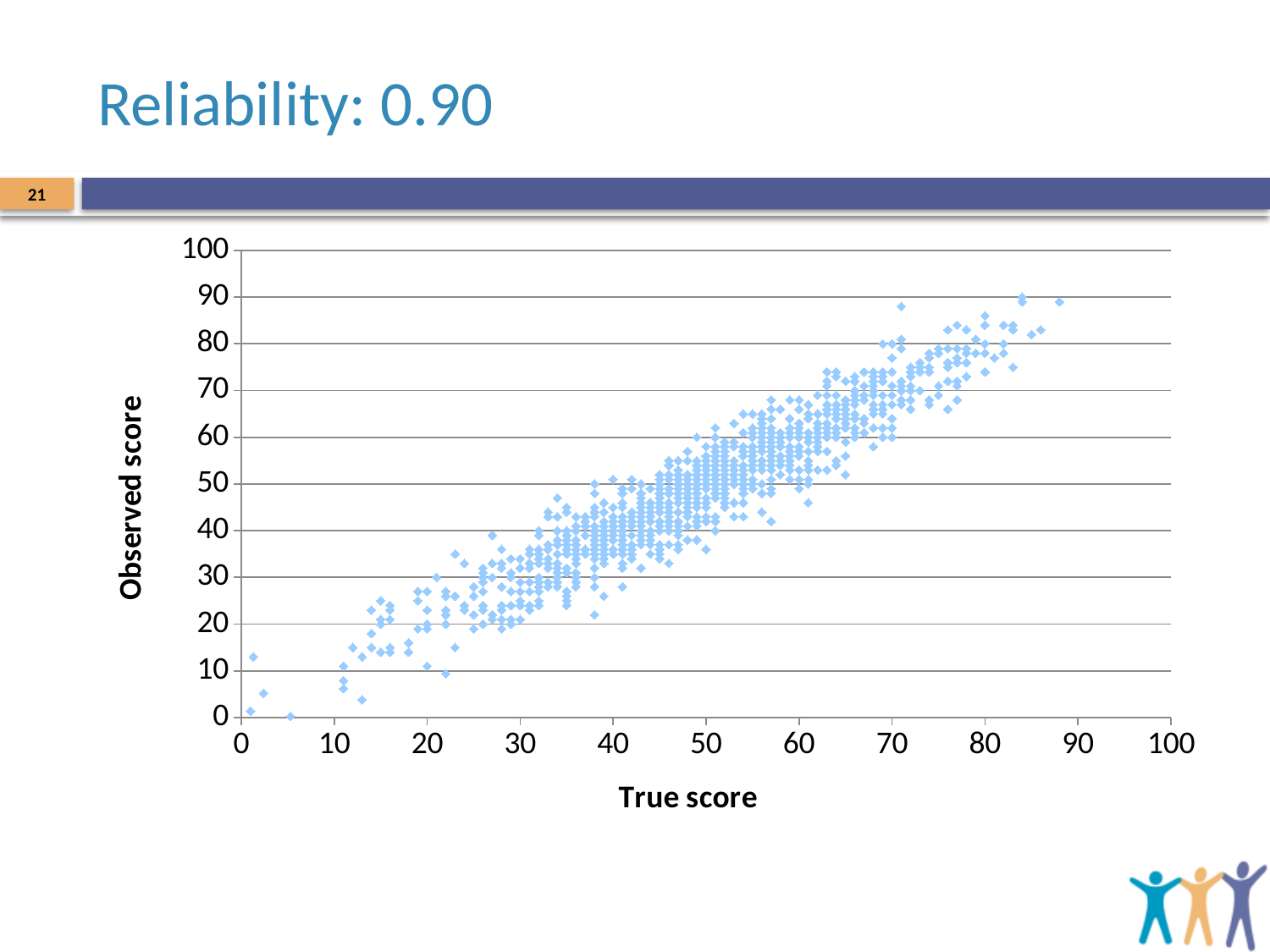
What is the label of the y axis? Observed score For points with a true score near 80, is the observed score greater or less than 50? greater What kind of chart is shown on the slide? scatter plot Do the observed scores rise or fall as the true score increases along the x axis? rise For points with a true score near 50, is the observed score greater or less than 80? less For points with a true score near 10, is the observed score greater or less than 30? less Are the observed scores for true scores near 30 generally greater or less than those for true scores near 70? less What is the label of the x axis? True score